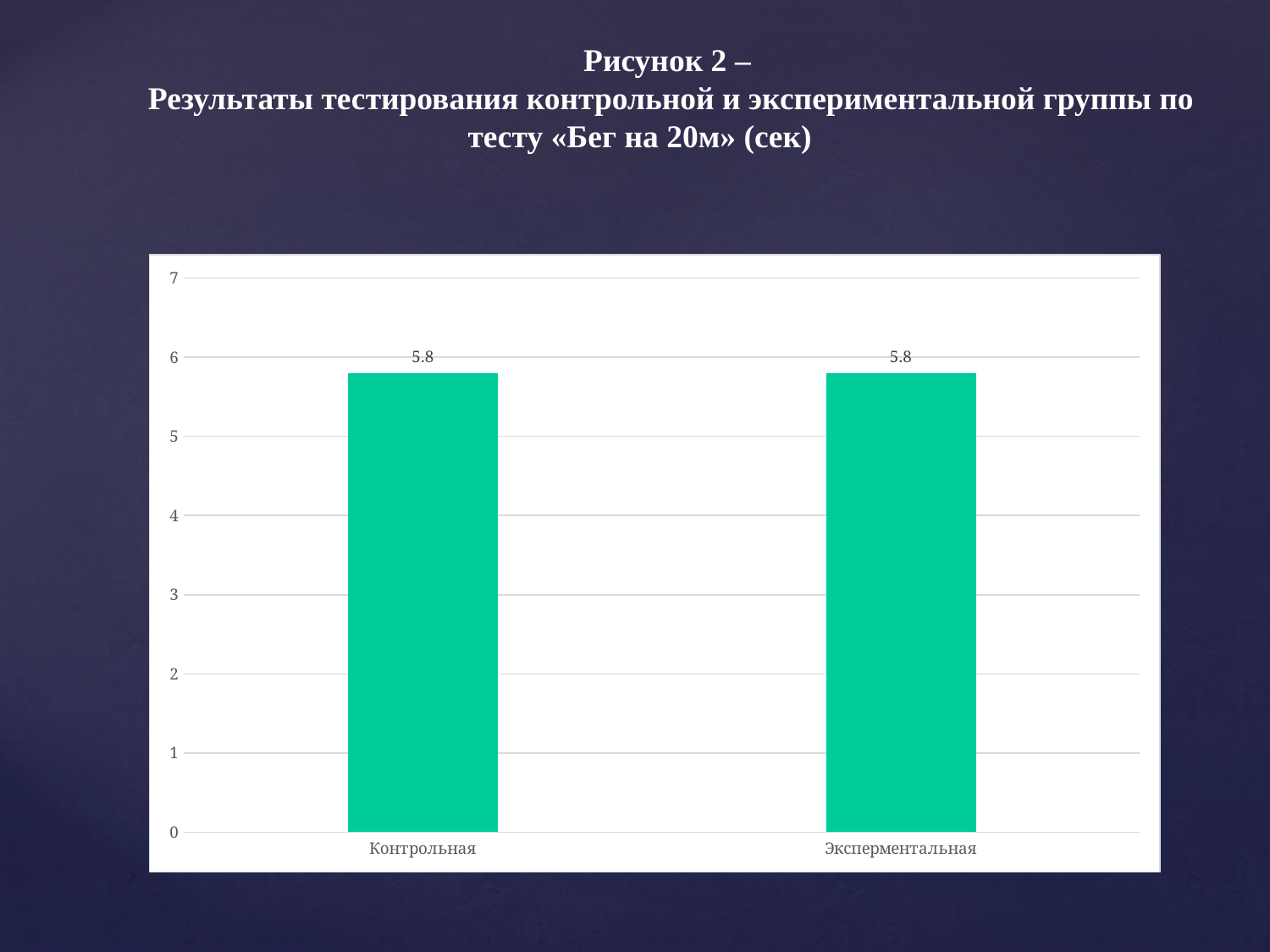
What colour are the bars in the chart? green What is the value for Эксперментальная? 5.8 What is the highest value shown on the vertical axis? 7 What is the value for Контрольная? 5.8 Is the value for Контрольная greater or less than 5? greater What is the difference between the values for Контрольная and Эксперментальная? 0 Is the value for Эксперментальная greater or less than 6? less Do the values rise, fall or stay the same from Контрольная to Эксперментальная? stay the same What kind of chart is shown on the slide? bar chart How many categories are shown on the x axis? 2